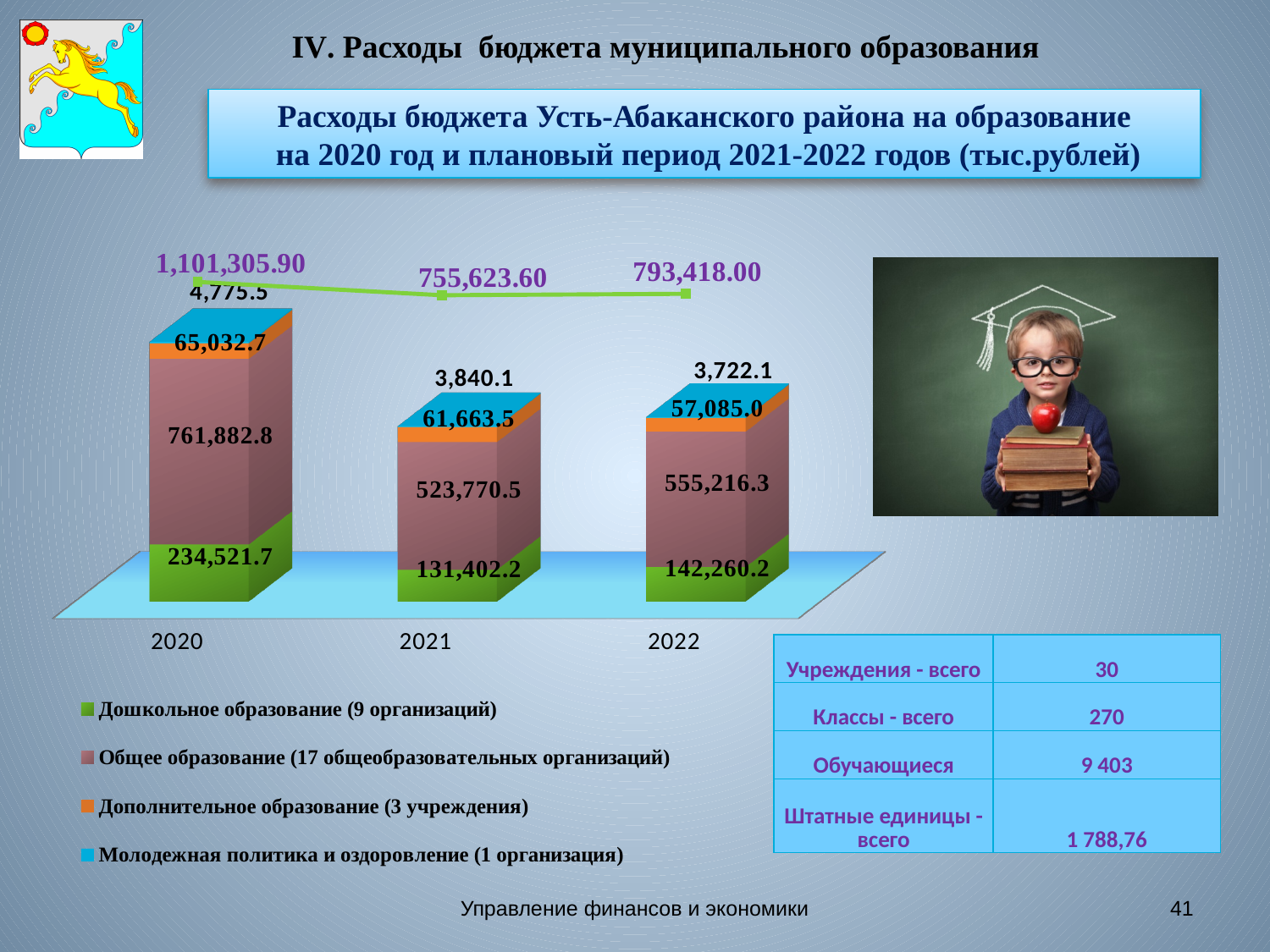
How many years are shown on the x axis of the chart? 3 In which year is the value for Дошкольное образование the lowest? 2021 What is the difference between the Дошкольное образование values for 2022 and 2021? 10,858.0 What value does the line above the bars show for 2021? 755,623.60 Does the value for Дополнительное образование rise or fall from 2020 to 2022? Falls In which year is the value for Общее образование the highest? 2020 How many series does the chart legend list? 4 What is the value for Дополнительное образование in 2022? 57,085.0 What is the value for Дошкольное образование in 2021? 131,402.2 What kind of chart is shown on the slide? Stacked bar chart with a line Which year has the larger value for Дополнительное образование, 2020 or 2021? 2020 What is the value for Общее образование in 2020? 761,882.8